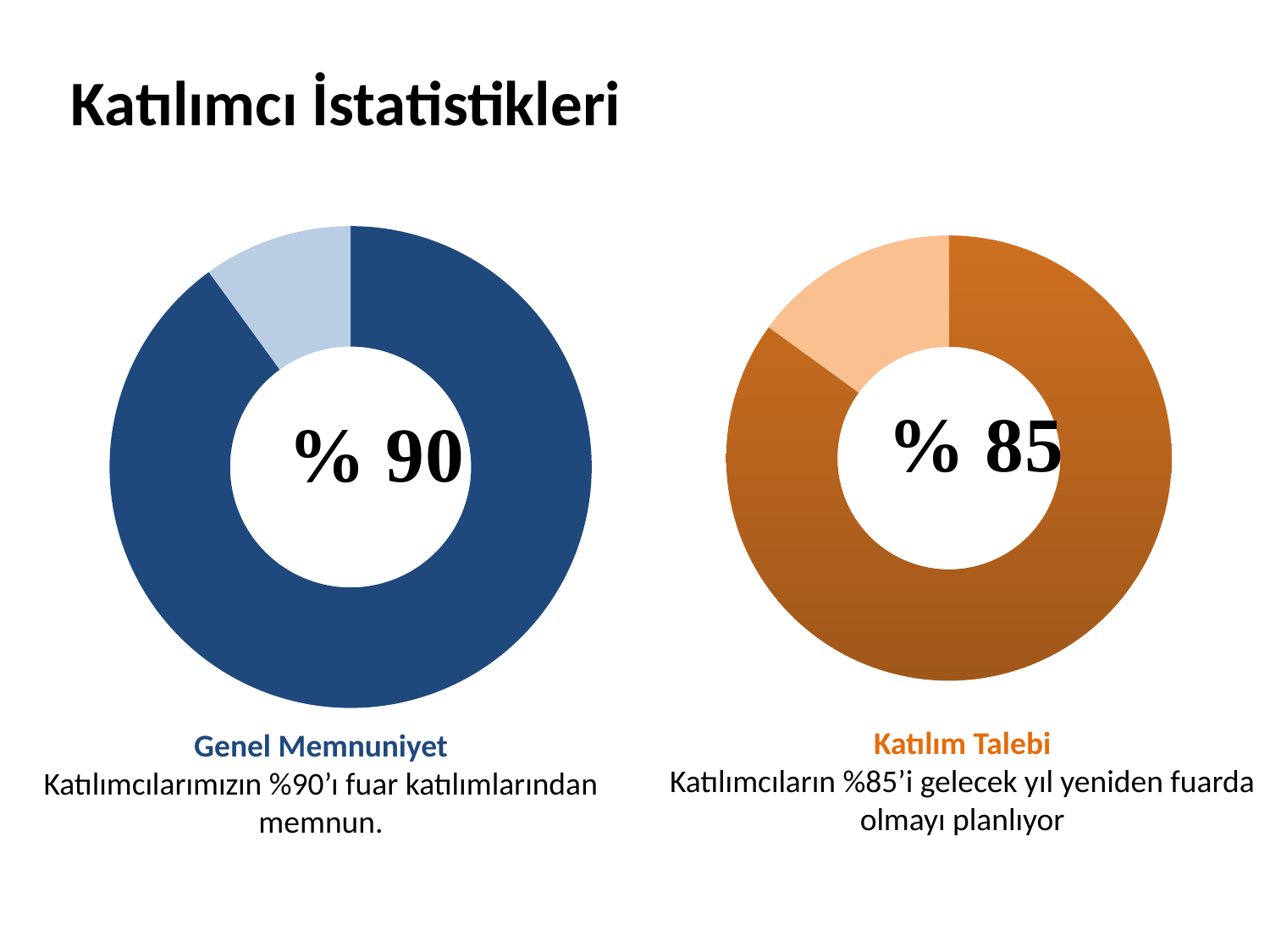
In the 'Genel Memnuniyet' chart on the left, what value is printed in the centre of the donut? % 90 What colour is the large slice of the 'Katılım Talebi' chart on the right? Orange What kind of chart is the 'Genel Memnuniyet' chart on the left? Donut (pie) chart What is the difference between the percentage shown in the 'Genel Memnuniyet' chart and the percentage shown in the 'Katılım Talebi' chart? 5 percentage points In the 'Genel Memnuniyet' chart on the left, what share of the donut does the large dark blue slice represent? % 90 How many slices does the 'Genel Memnuniyet' chart on the left have? 2 What kind of chart is the 'Katılım Talebi' chart on the right? Donut (pie) chart How many slices does the 'Katılım Talebi' chart on the right have? 2 In the 'Katılım Talebi' chart on the right, what value is printed in the centre of the donut? % 85 In the 'Katılım Talebi' chart on the right, what share of the donut does the large dark orange slice represent? % 85 What is the title of the chart on the left? Genel Memnuniyet Which chart shows the larger percentage in its centre, 'Genel Memnuniyet' on the left or 'Katılım Talebi' on the right? Genel Memnuniyet